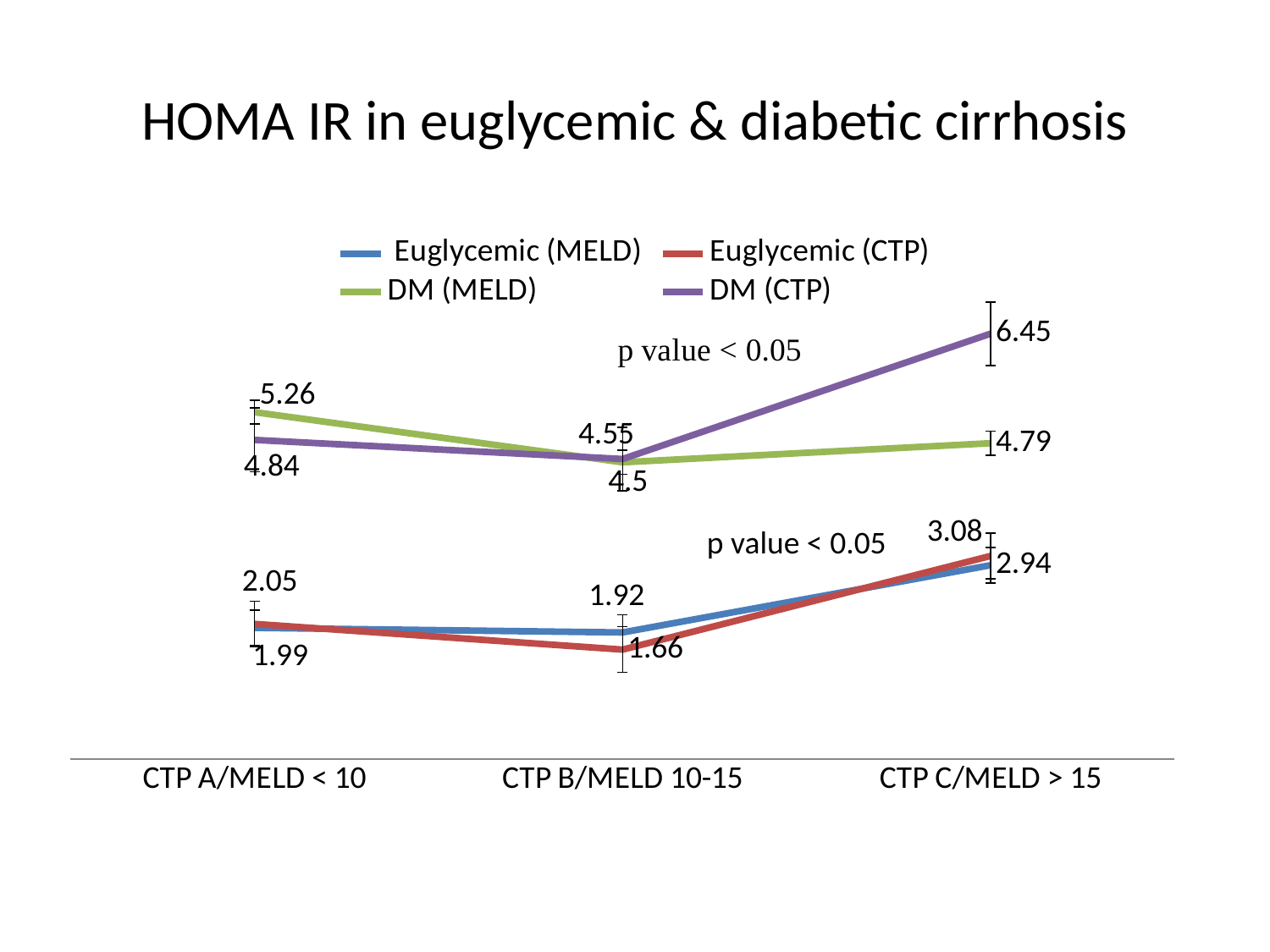
How many categories are shown on the x axis? 3 What is the difference between the DM (CTP) and DM (MELD) values at CTP C/MELD > 15? 1.66 What is the DM (CTP) value at CTP C/MELD > 15? 6.45 What is the DM (MELD) value at CTP C/MELD > 15? 4.79 At CTP C/MELD > 15, which is larger: Euglycemic (CTP) or Euglycemic (MELD)? Euglycemic (CTP) What is the Euglycemic (CTP) value at CTP B/MELD 10-15? 1.66 In which category is the Euglycemic (CTP) value lowest? CTP B/MELD 10-15 In which category is the DM (CTP) value highest? CTP C/MELD > 15 What is the title of the chart? HOMA IR in euglycemic & diabetic cirrhosis What is the DM (MELD) value at CTP A/MELD < 10? 5.26 What kind of chart is shown on the slide? line chart How many series does the legend list? 4